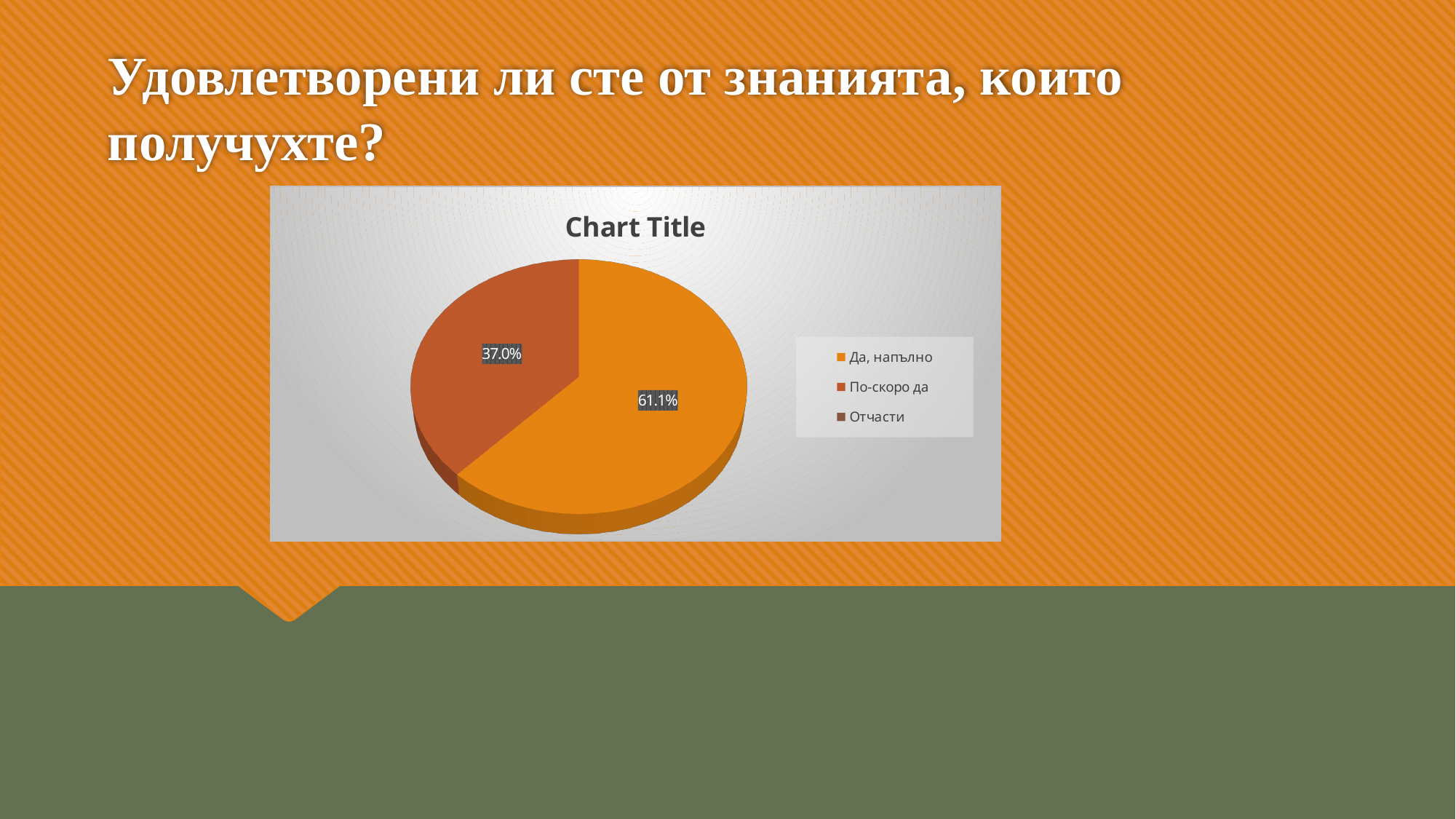
What share of the pie does the "По-скоро да" slice represent? 37.0% Which slice is larger, "Да, напълно" or "По-скоро да"? Да, напълно Which category has the smallest slice of the pie? По-скоро да By how many percentage points does the "Да, напълно" slice exceed the "По-скоро да" slice? 24.1 percentage points Which legend entry is shown in the lighter orange colour? Да, напълно How many categories does the legend list? 3 What percentage of the pie is labelled for the "По-скоро да" slice? 37.0% What percentage of the pie is labelled for the "Да, напълно" slice? 61.1% What kind of chart is shown on the slide? Pie chart What is the title shown above the chart? Chart Title Which category has the largest slice of the pie? Да, напълно